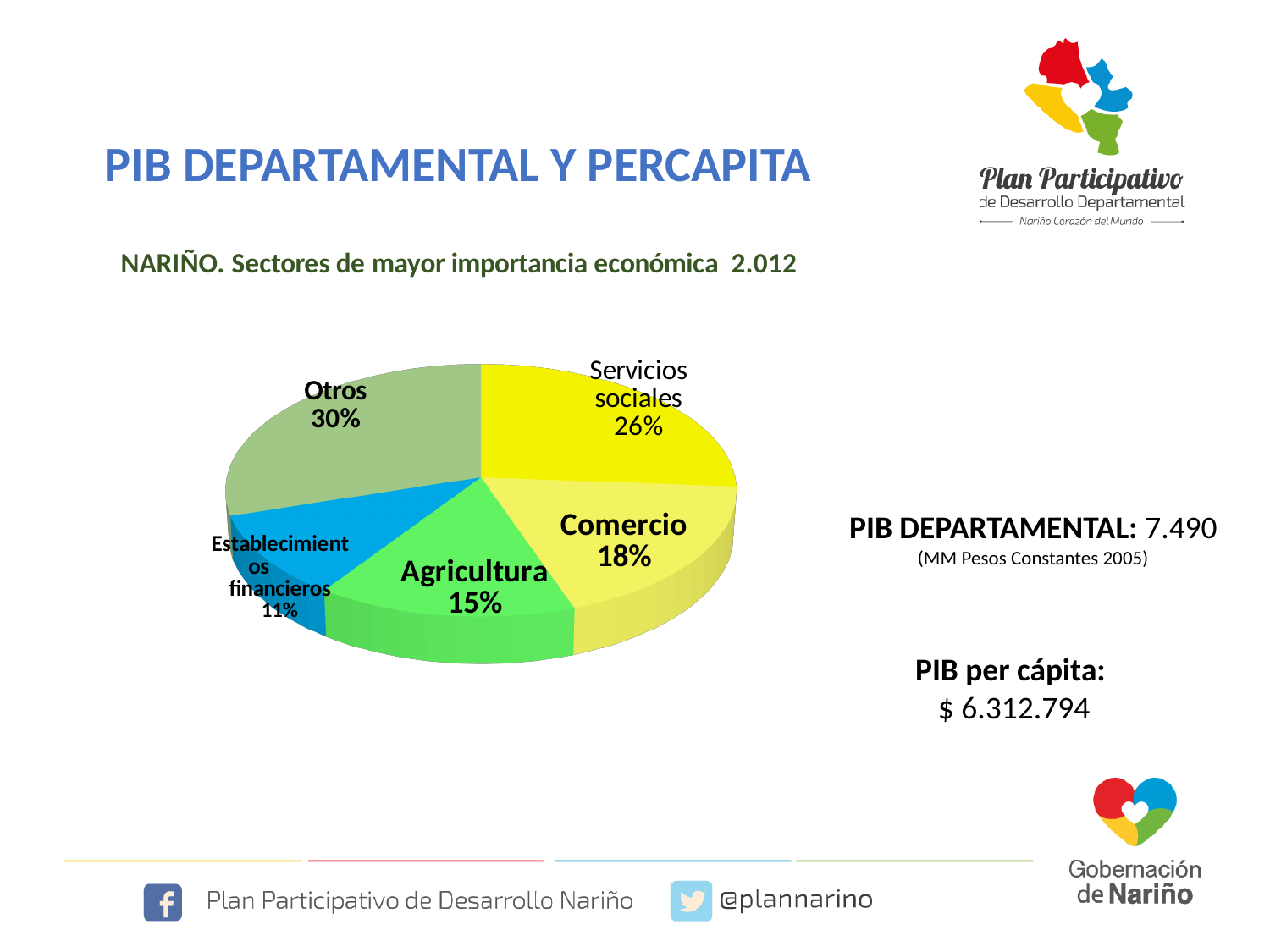
Which is larger, Agricultura or Comercio? Comercio What is the value shown for Agricultura? 15% What is the value shown for Comercio? 18% What is the difference in percentage points between Servicios sociales and Comercio? 8 What is the title of the chart? NARIÑO. Sectores de mayor importancia económica 2.012 What is the value shown for Establecimientos financieros? 11% Which sector has the largest share of the pie? Otros How many sectors are shown in the pie chart? 5 What kind of chart is shown on the slide? Pie chart Which sector has the smallest share of the pie? Establecimientos financieros What share of the pie does Otros represent? 30% What is the value shown for Servicios sociales? 26%